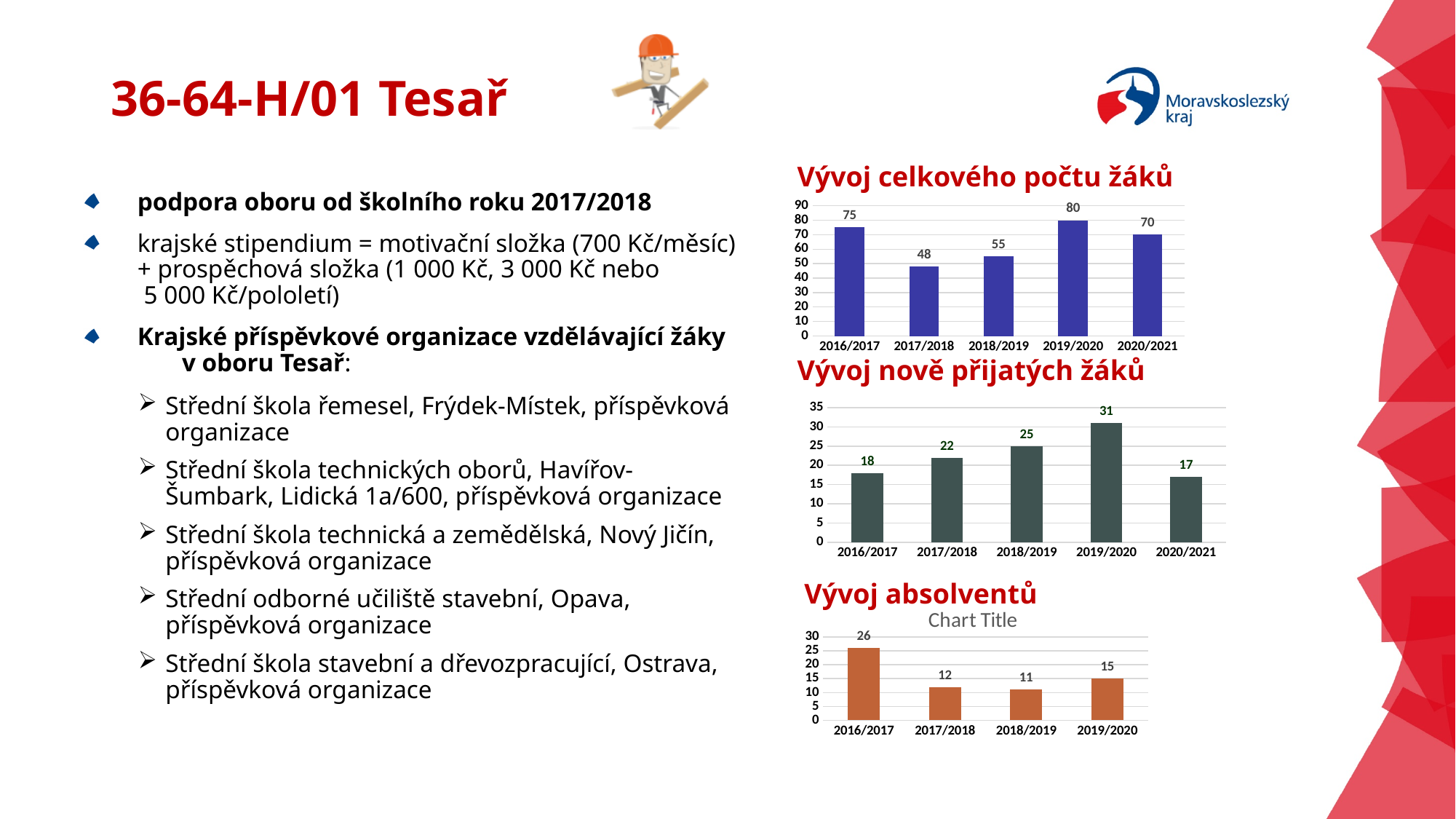
In the 'Vývoj celkového počtu žáků' chart, which school year has the lowest value? 2017/2018 How many bars are in the 'Vývoj celkového počtu žáků' chart? 5 In the 'Vývoj nově přijatých žáků' chart, do the values rise or fall from 2016/2017 to 2019/2020? rise In the 'Vývoj celkového počtu žáků' chart, what is the difference between the values for 2016/2017 and 2017/2018? 27 How many bars are in the 'Vývoj absolventů' chart? 4 In the 'Vývoj nově přijatých žáků' chart, is the value for 2017/2018 or 2020/2021 larger? 2017/2018 In the 'Vývoj nově přijatých žáků' chart, what is the value for 2018/2019? 25 What type of chart is the 'Vývoj absolventů' chart? bar chart In the 'Vývoj celkového počtu žáků' chart, what is the value for 2019/2020? 80 In the 'Vývoj absolventů' chart, what is the value for 2016/2017? 26 In the 'Vývoj nově přijatých žáků' chart, which school year has the highest value? 2019/2020 In the 'Vývoj absolventů' chart, which school year has the lowest value? 2018/2019